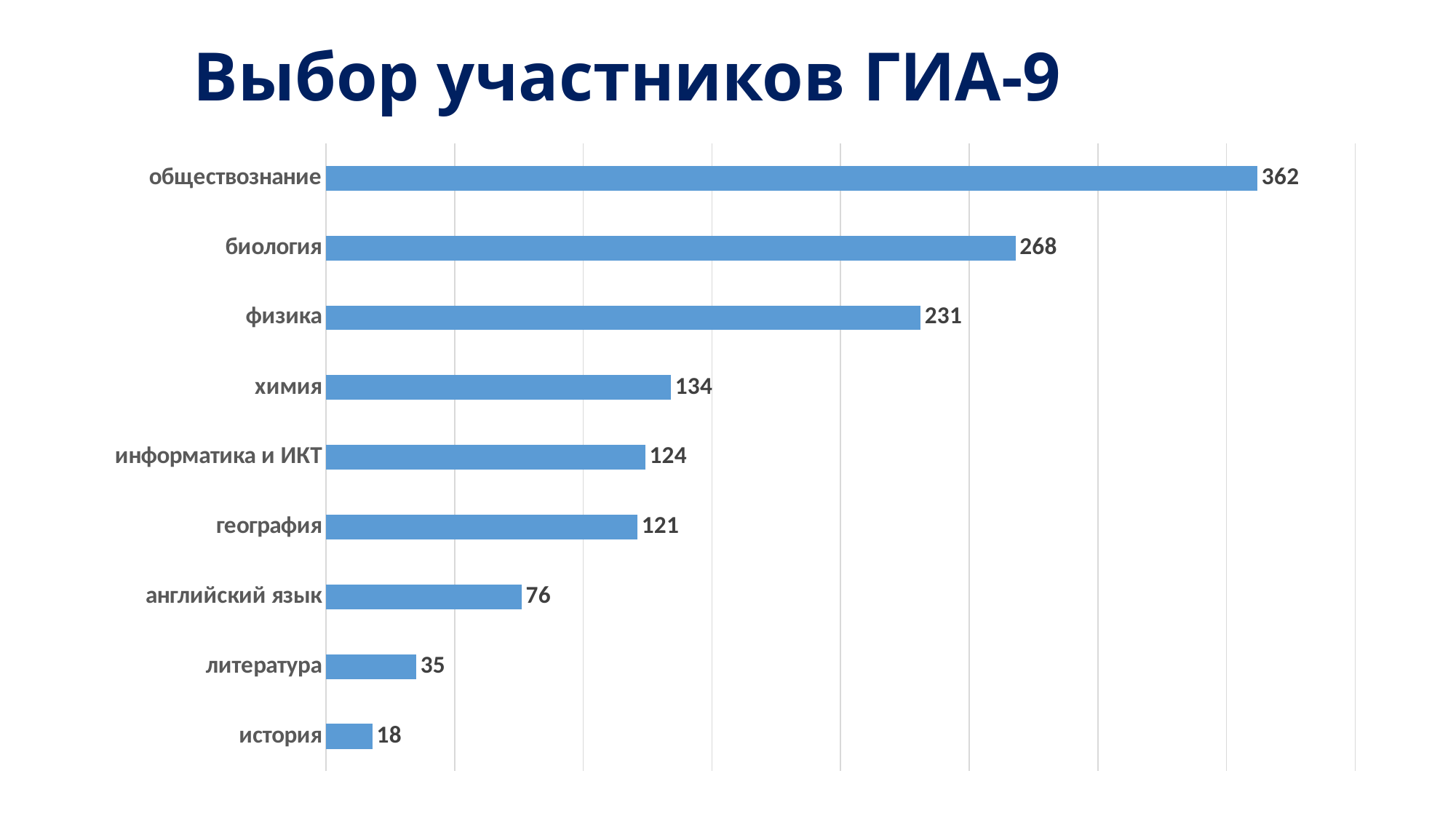
Which is larger, the value for информатика и ИКТ or the value for география? информатика и ИКТ What is the difference between the values for обществознание and история? 344 What is the difference between the values for биология and физика? 37 What is the value for обществознание? 362 Which category has the lowest value? история What is the value for химия? 134 What is the title of the slide? Выбор участников ГИА-9 Which is larger, the value for английский язык or the value for химия? химия What is the value for литература? 35 What kind of chart is shown on the slide? bar chart How many categories are shown in the chart? 9 Which category has the highest value? обществознание